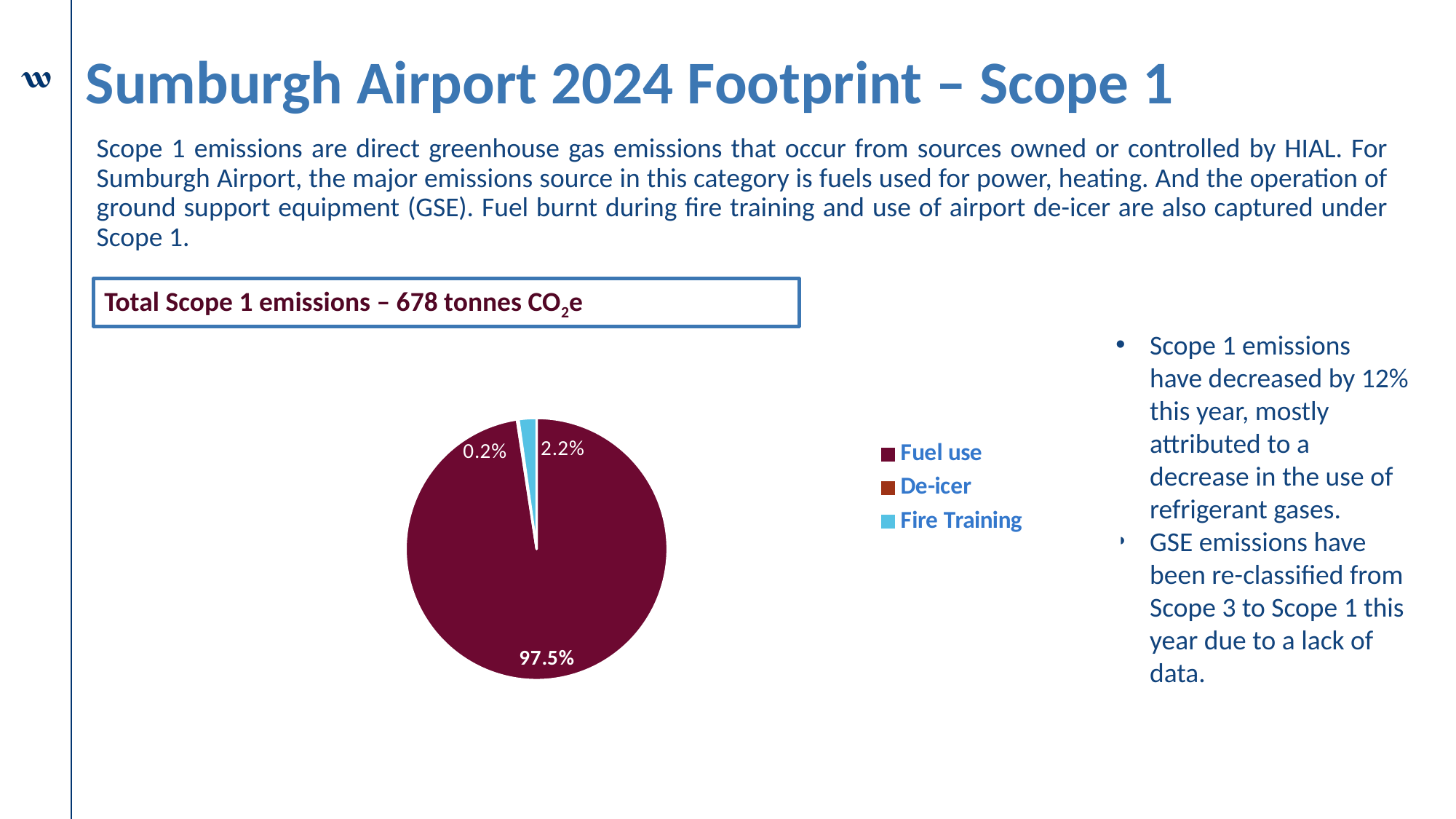
What kind of chart is shown on the slide? Pie chart Which category has the smallest slice of the pie? De-icer What share of the pie does De-icer account for? 0.2% What share of the pie does Fire Training account for? 2.2% What is the difference in percentage points between the Fire Training slice and the De-icer slice? 2.0 What share of the pie does Fuel use account for? 97.5% How many entries does the legend list? 3 What is the difference in percentage points between the Fuel use slice and the Fire Training slice? 95.3 Which is larger, the Fire Training slice or the De-icer slice? Fire Training How many categories does the pie chart show? 3 Which category has the largest slice of the pie? Fuel use What colour is the Fire Training slice in the pie chart? Light blue